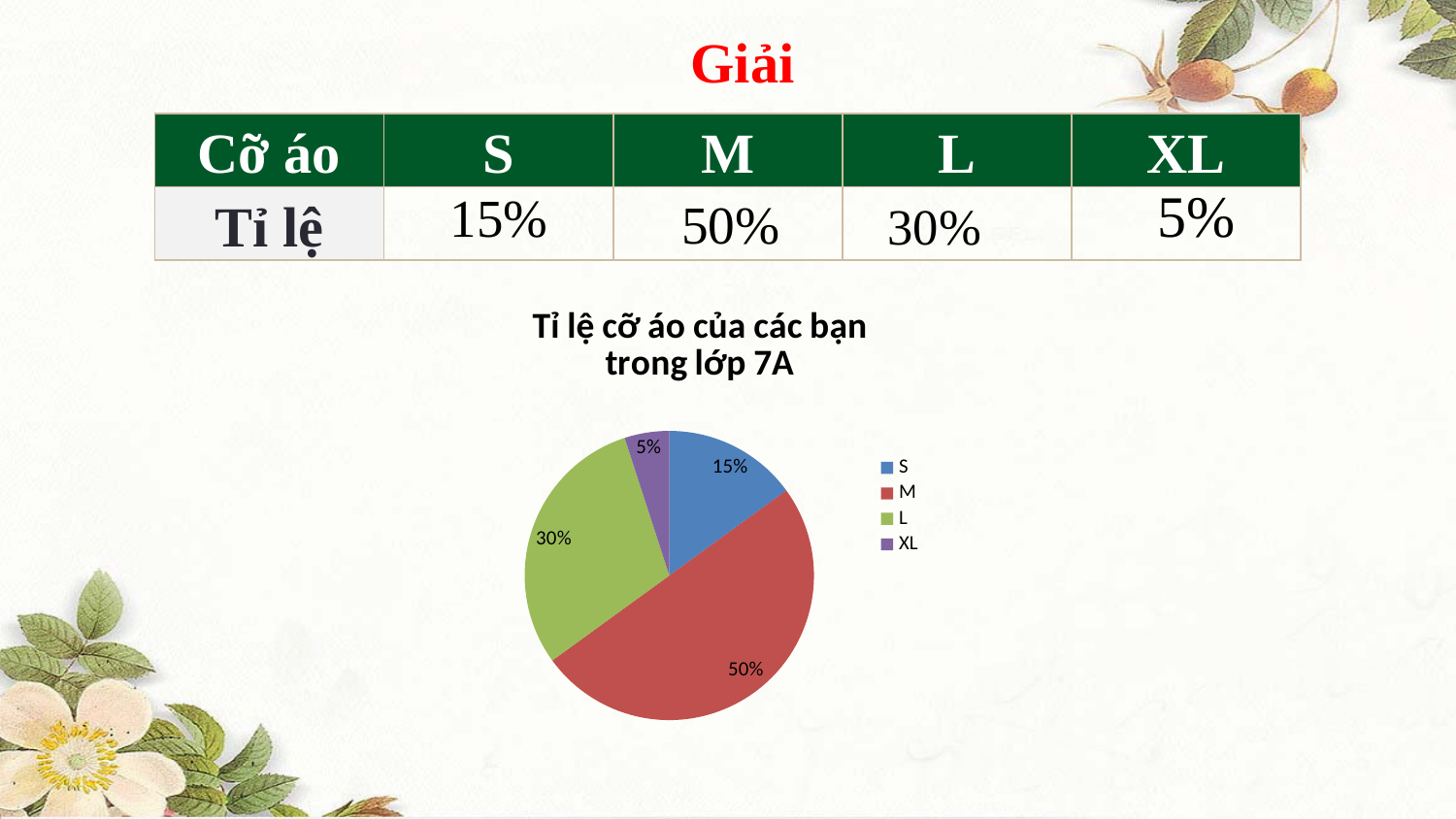
What share of the pie does size S have? 15% How many slices does the pie chart have? 4 What is the difference between the shares of size M and size L? 20% What share of the pie does size M have? 50% What colour is the slice for size L? green What share of the pie does size XL have? 5% What is the title of the chart? Tỉ lệ cỡ áo của các bạn trong lớp 7A Which size has the largest slice of the pie? M Which size has the smallest slice of the pie? XL Which is larger, the share for size S or the share for size L? L What kind of chart is shown on the slide? pie chart